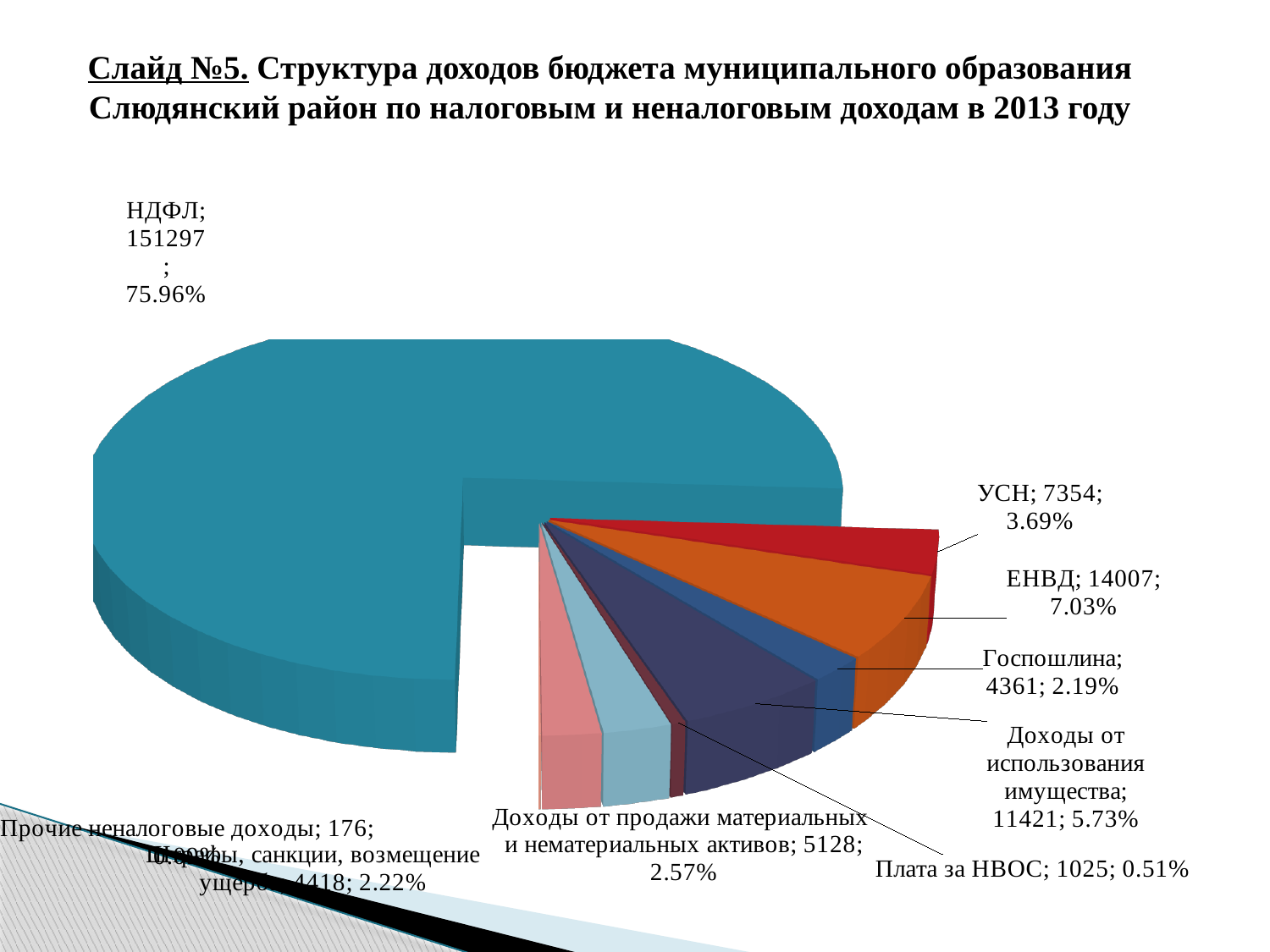
Which category has the smallest value in the chart? Прочие неналоговые доходы How many slices does the pie chart have? 9 What share of the pie does НДФЛ represent? 75.96% Which category has the largest slice of the pie? НДФЛ What is the value shown for ЕНВД? 14007 What is the difference between the values for ЕНВД and УСН? 6653 What is the value shown for Доходы от использования имущества? 11421 What percentage is shown for УСН? 3.69% What is the value shown for НДФЛ? 151297 Which is larger, the value for Госпошлина or the value for Штрафы, санкции, возмещение ущерба? Штрафы, санкции, возмещение ущерба What kind of chart is shown on the slide? pie chart What percentage is shown for Плата за НВОС? 0.51%